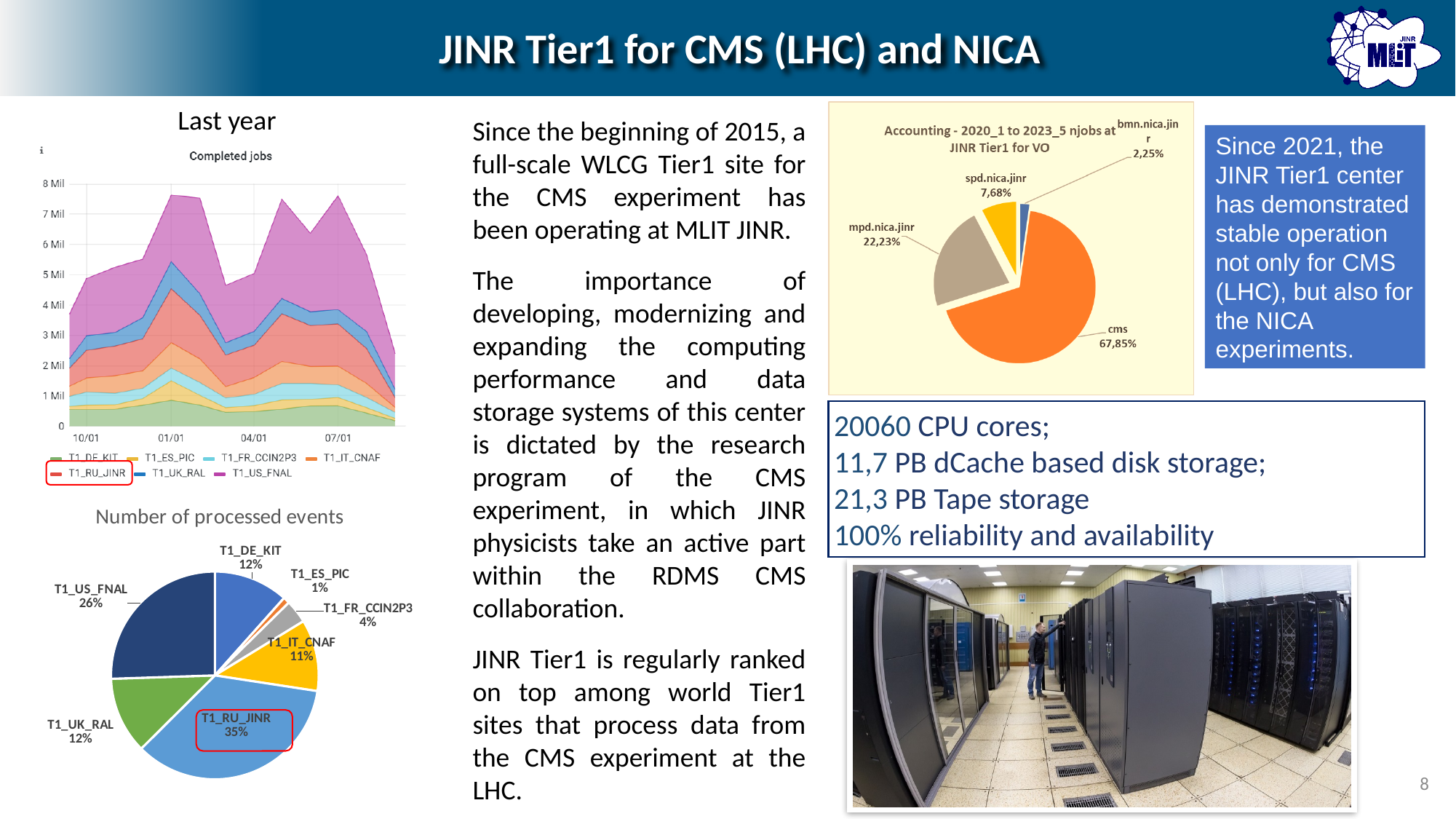
In the 'Number of processed events' pie chart, what share does T1_RU_JINR have? 35% In the 'Accounting - 2020_1 to 2023_5 njobs at JINR Tier1 for VO' pie chart, what share does mpd.nica.jinr have? 22,23% In the 'Number of processed events' pie chart, which site has the smallest share? T1_ES_PIC In the 'Accounting - 2020_1 to 2023_5 njobs at JINR Tier1 for VO' pie chart, which VO has the smallest share? bmn.nica.jinr In the 'Number of processed events' pie chart, what is the difference between the shares of T1_RU_JINR and T1_US_FNAL? 9% In the 'Number of processed events' pie chart, which site has the largest share? T1_RU_JINR In the 'Number of processed events' pie chart, which is larger: T1_IT_CNAF or T1_FR_CCIN2P3? T1_IT_CNAF In the 'Completed jobs' chart, how many series does the legend list? 7 In the 'Accounting - 2020_1 to 2023_5 njobs at JINR Tier1 for VO' pie chart, what share does cms have? 67,85% What kind of chart is the 'Completed jobs' chart? Stacked area chart In the 'Number of processed events' pie chart, what share does T1_US_FNAL have? 26% In the 'Number of processed events' pie chart, how many sites are shown? 7